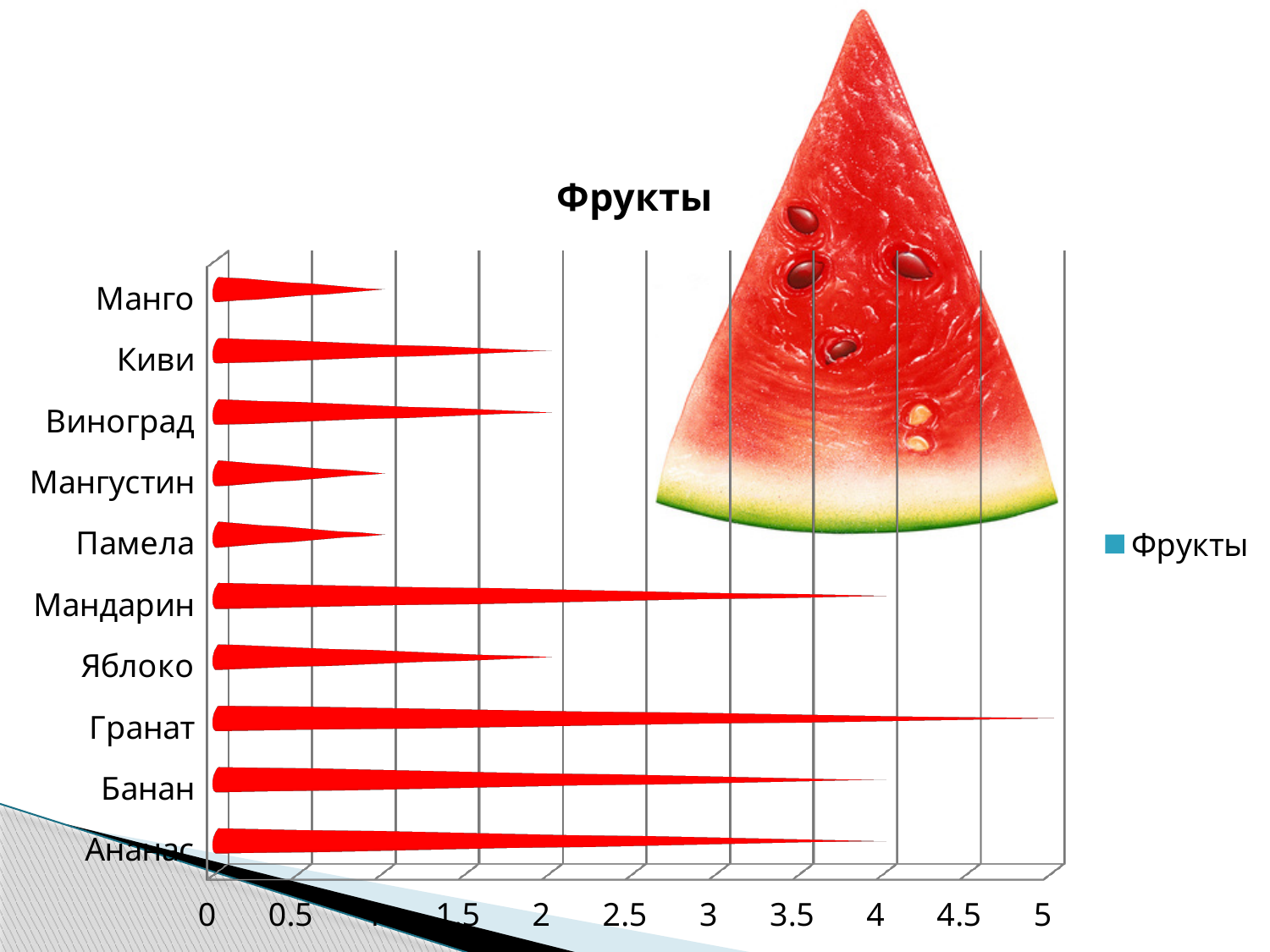
What kind of chart is shown on the slide? bar chart Which is larger, the value for Киви or the value for Памела? Киви Is the value for Банан greater or less than 3? greater How many categories are plotted on the chart? 10 How many series does the legend list? 1 Is the value for Мандарин greater or less than 3? greater What is the title of the chart? Фрукты Is the value for Гранат greater or less than 4.5? greater Which category has the highest value? Гранат Which is larger, the value for Мандарин or the value for Яблоко? Мандарин